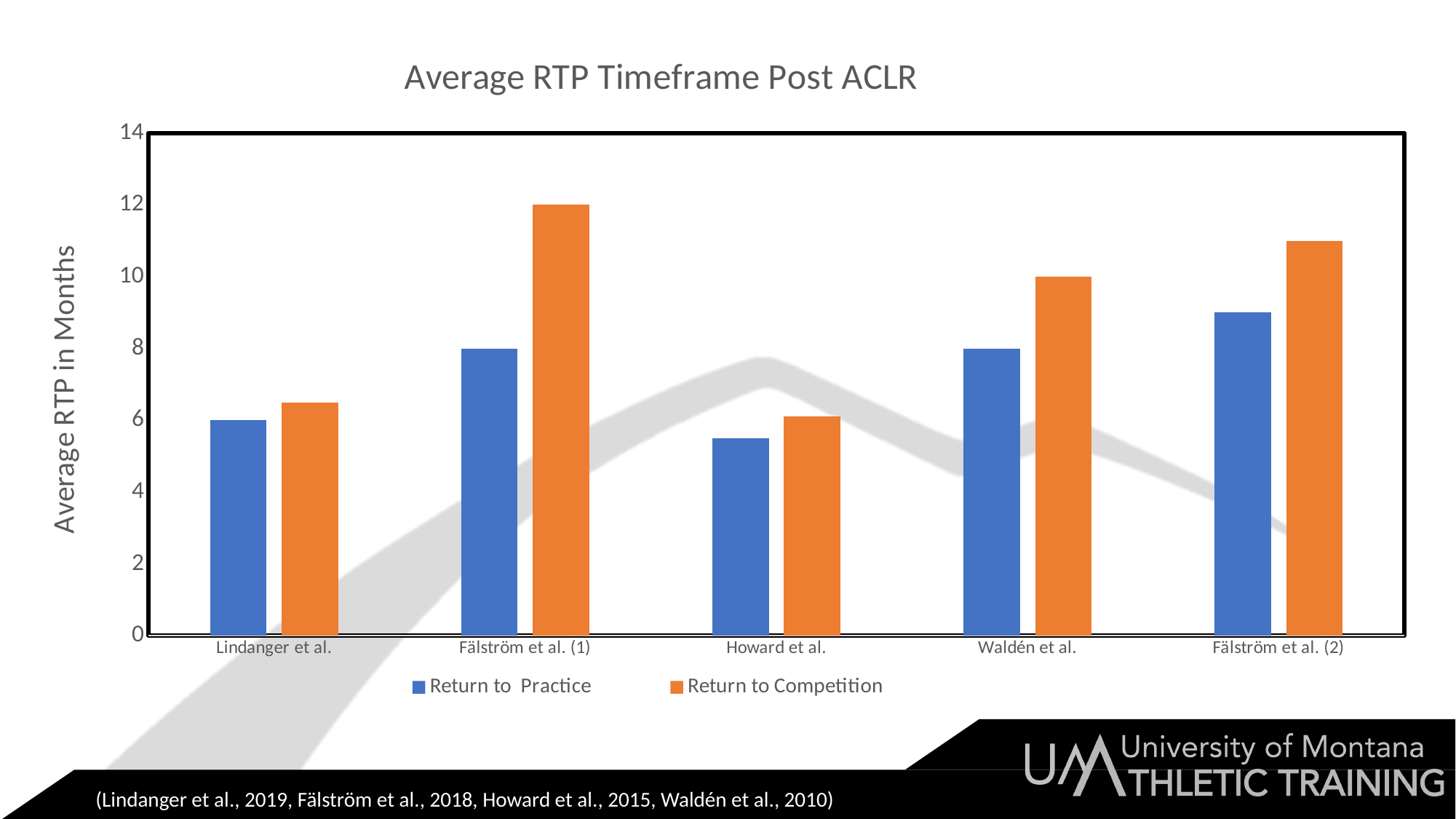
Which study has the highest Return to Competition value? Fälström et al. (1) What type of chart is shown on the slide? Bar chart Is the Return to Competition value for Fälström et al. (2) greater or less than 10? greater Which is larger for Waldén et al.: Return to Practice or Return to Competition? Return to Competition Is the Return to Practice value for Howard et al. greater or less than 6? less What is the title of the chart? Average RTP Timeframe Post ACLR What is the label on the y axis? Average RTP in Months Which is larger: the Return to Competition value for Fälström et al. (1) or for Fälström et al. (2)? Fälström et al. (1) Which study has the lowest Return to Practice value? Howard et al. How many studies (categories) are shown on the x axis? 5 Is the Return to Competition value for Fälström et al. (1) greater or less than 10? greater How many series does the legend list? 2